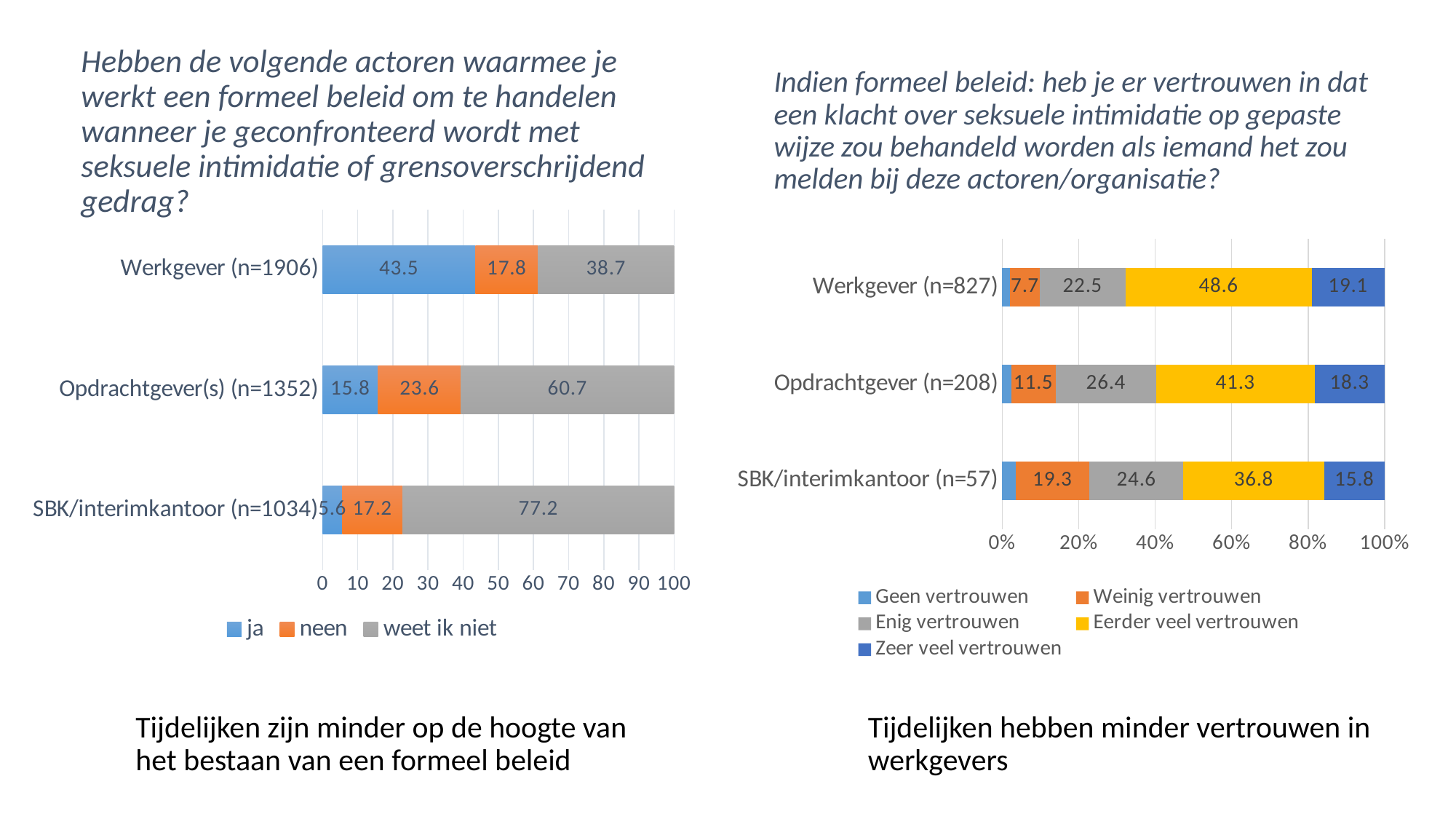
In the left chart, what is the 'ja' value for Werkgever (n=1906)? 43.5 In the right chart, which category has the highest 'Zeer veel vertrouwen' value? Werkgever (n=827) In the right chart, is the 'Enig vertrouwen' value larger for Opdrachtgever (n=208) or for Werkgever (n=827)? Opdrachtgever (n=208) In the right chart, what is the 'Eerder veel vertrouwen' value for Werkgever (n=827)? 48.6 In the right chart, how many series does the legend list? 5 In the left chart, what is the difference between the 'neen' values for Opdrachtgever(s) (n=1352) and Werkgever (n=1906)? 5.8 In the left chart, which category has the lowest 'ja' value? SBK/interimkantoor (n=1034) In the left chart, what is the 'weet ik niet' value for SBK/interimkantoor (n=1034)? 77.2 In the left chart, how many series does the legend list? 3 In the left chart, which category has the highest 'weet ik niet' value? SBK/interimkantoor (n=1034) In the right chart, what is the 'Weinig vertrouwen' value for SBK/interimkantoor (n=57)? 19.3 What kind of chart is the left chart? Stacked bar chart